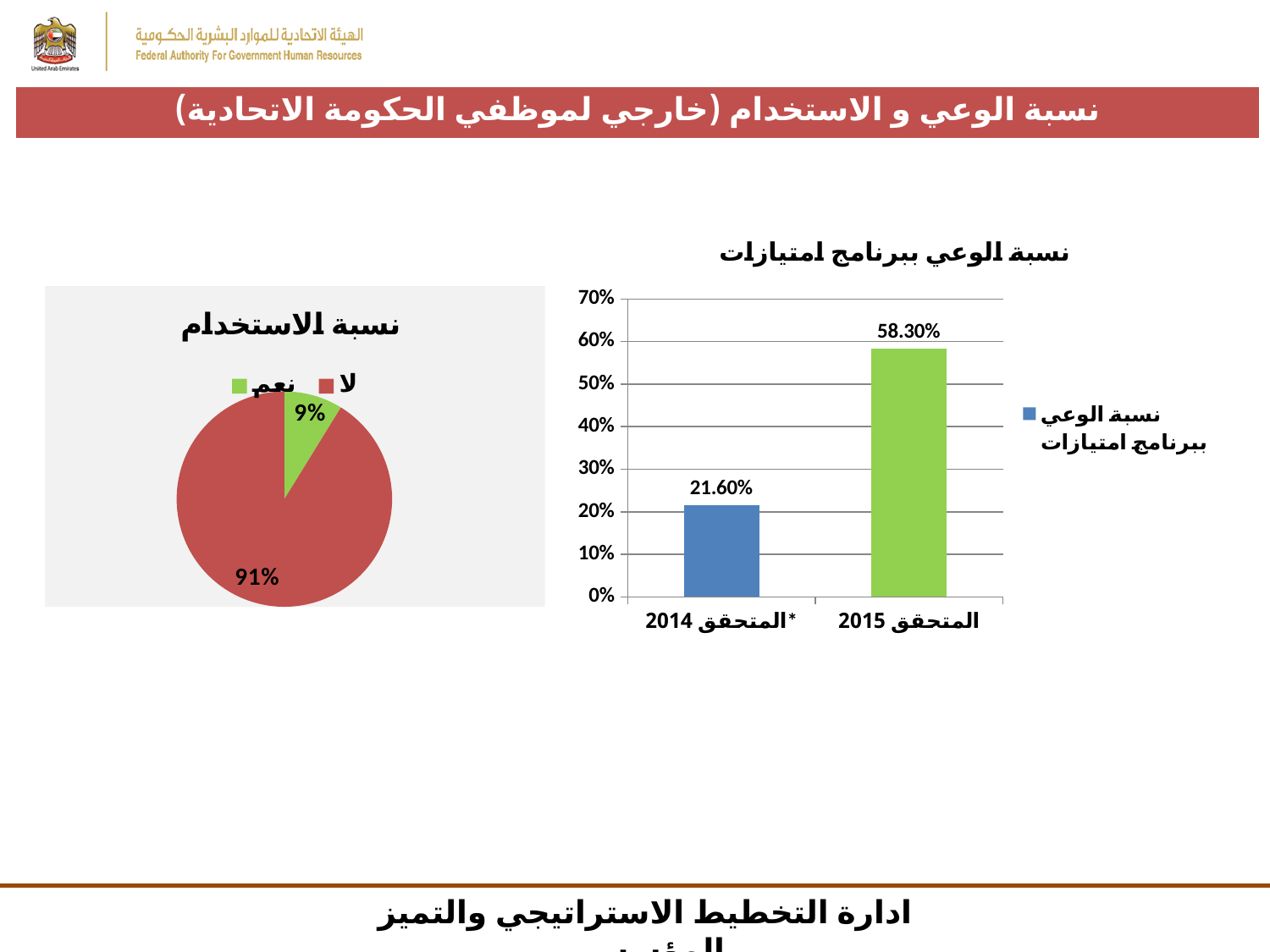
In the pie chart titled نسبة الاستخدام, what share does the slice لا have? 91% In the bar chart titled نسبة الوعي ببرنامج امتيازات, how many bars are plotted? 2 In the bar chart titled نسبة الوعي ببرنامج امتيازات, what is the value for المتحقق 2015? 58.30% In the bar chart titled نسبة الوعي ببرنامج امتيازات, do the values rise or fall from 2014 to 2015? rise In the bar chart titled نسبة الوعي ببرنامج امتيازات, which category has the higher value? المتحقق 2015 What kind of chart is the chart titled نسبة الوعي ببرنامج امتيازات? bar chart In the pie chart titled نسبة الاستخدام, what share does the slice نعم have? 9% In the bar chart titled نسبة الوعي ببرنامج امتيازات, what is the difference between the 2015 and 2014 values? 36.70% In the pie chart titled نسبة الاستخدام, which slice is the largest? لا In the bar chart titled نسبة الوعي ببرنامج امتيازات, what is the value for المتحقق 2014*? 21.60% In the pie chart titled نسبة الاستخدام, what colour is the slice labelled نعم? green In the pie chart titled نسبة الاستخدام, how many slices are there? 2